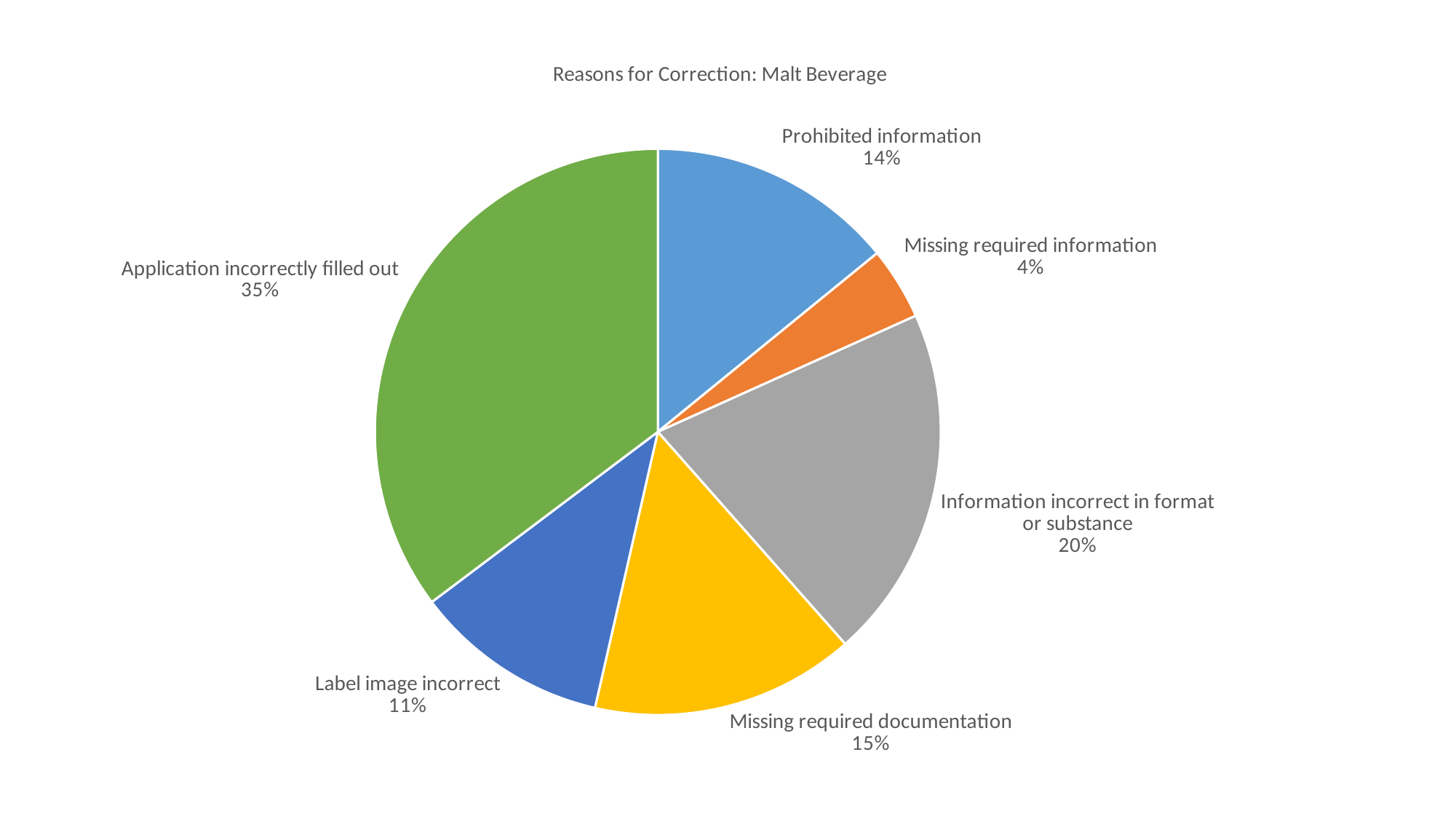
What type of chart is shown on the slide? pie chart What share of the pie is Application incorrectly filled out? 35% What percentage is shown for Information incorrect in format or substance? 20% What percentage is shown for Missing required information? 4% What percentage is shown for Prohibited information? 14% How many slices does the pie chart have? 6 Which reason for correction has the largest share? Application incorrectly filled out What is the difference in percentage points between Application incorrectly filled out and Information incorrect in format or substance? 15 What percentage is shown for Label image incorrect? 11% What is the title of the chart? Reasons for Correction: Malt Beverage Which is larger, Missing required documentation or Prohibited information? Missing required documentation Which reason for correction has the smallest share? Missing required information